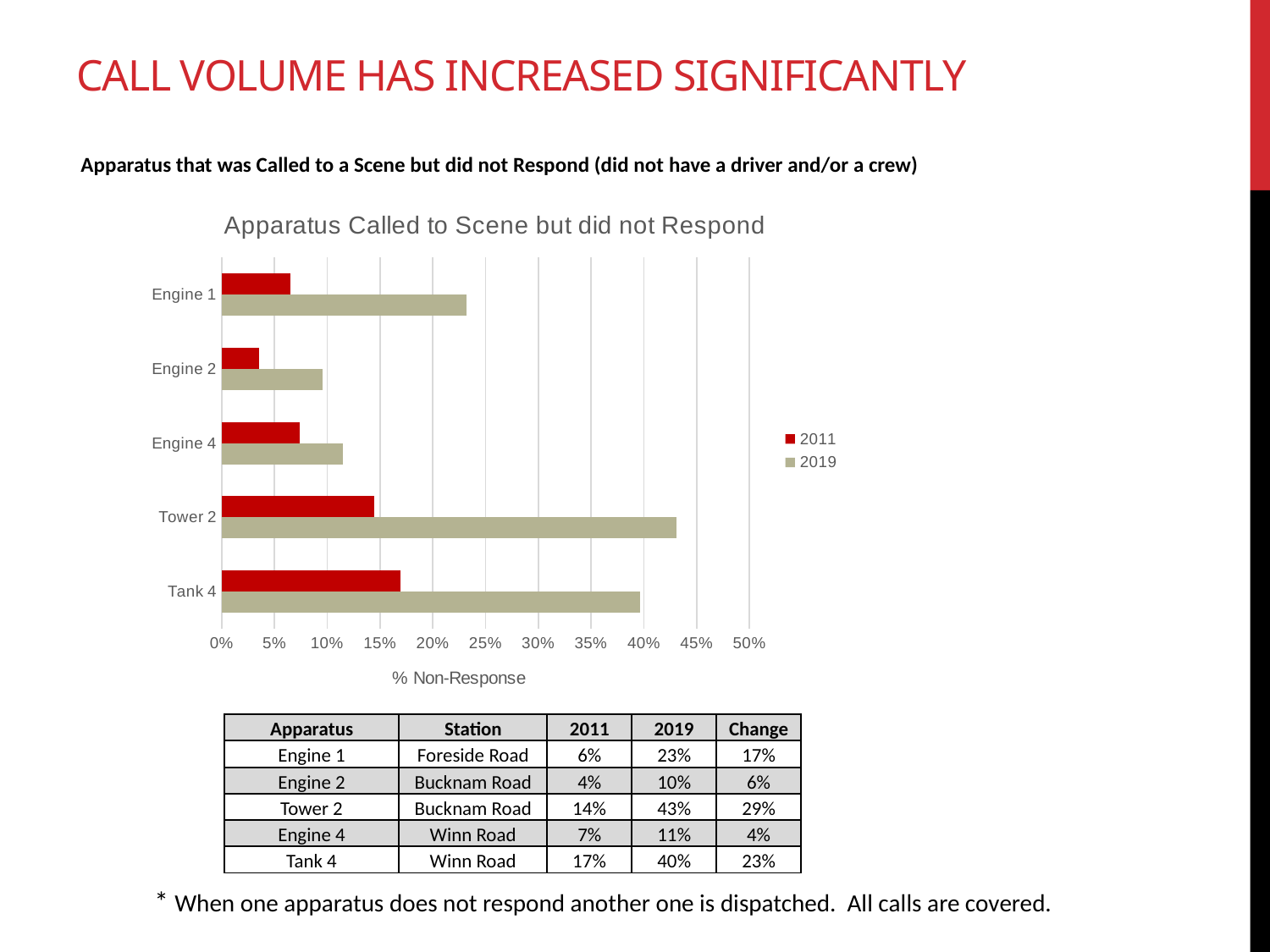
What is the 2019 non-response value for Tower 2? 43% What is the title of the chart? Apparatus Called to Scene but did not Respond How many series does the chart legend list? 2 What kind of chart is shown on the slide? bar chart How many apparatus categories are plotted on the chart? 5 Which apparatus has the lowest 2011 non-response value? Engine 2 What is the 2011 non-response value for Tank 4? 17% Is the 2019 value for Tower 2 greater or less than 40%? greater What is the difference between the 2019 and 2011 values for Engine 1? 17% Is the 2011 value for Engine 2 greater or less than 5%? less Which apparatus has the highest 2019 non-response value? Tower 2 Which is larger, the 2019 value for Tank 4 or the 2019 value for Engine 4? Tank 4